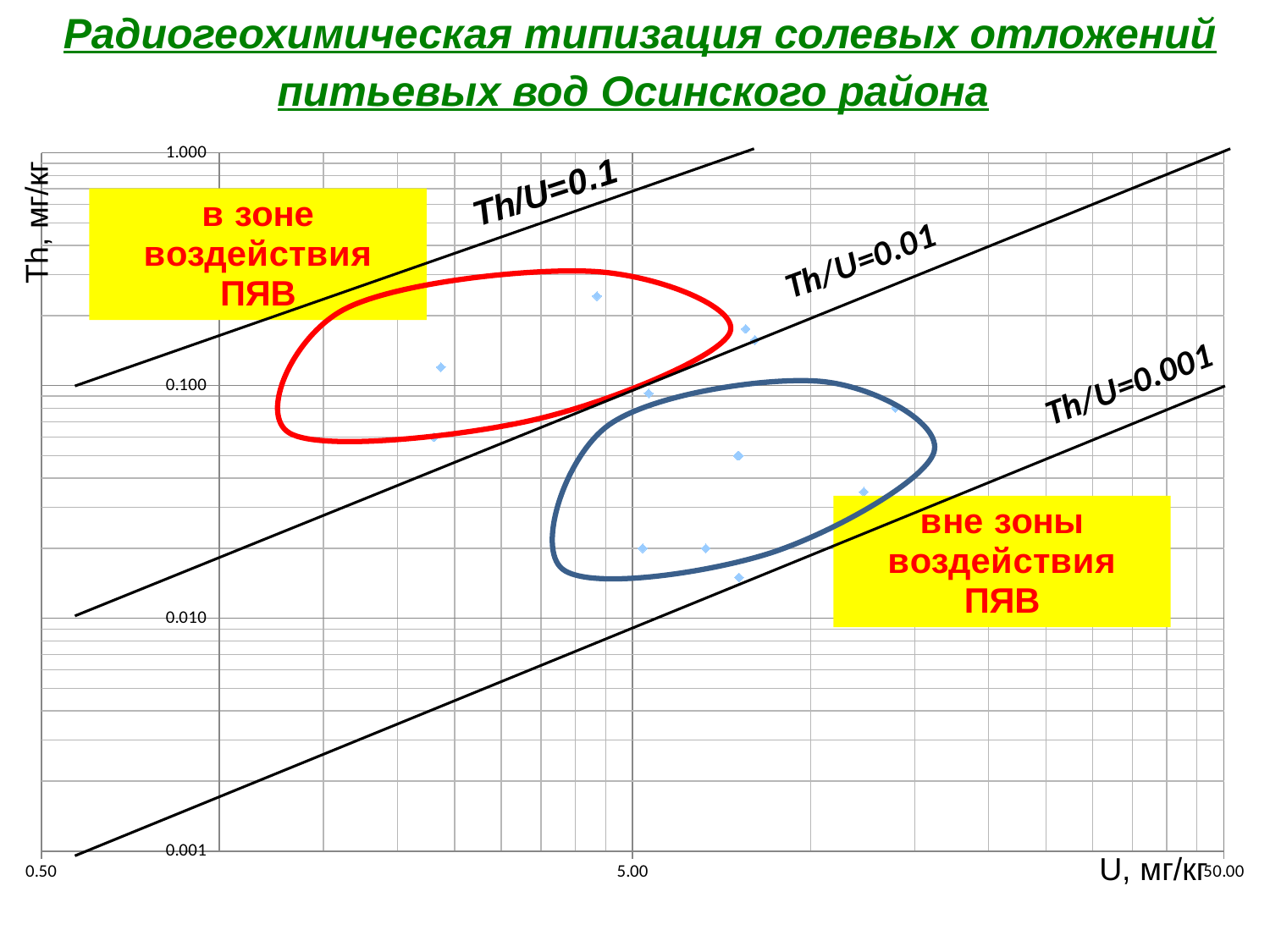
Are the points inside the blue ellipse above or below the Th/U=0.1 line? below Which group of points lies higher on the Th axis overall: the red ellipse group or the blue ellipse group? the red ellipse group How many Th/U ratio reference lines are drawn on the chart? 3 Is the highest point inside the red ellipse greater or less than 0.100 on the Th axis? greater What is the title of the chart on the slide? Радиогеохимическая типизация солевых отложений питьевых вод Осинского района Which Th/U ratio line is the topmost on the chart? Th/U=0.1 What label is written inside the yellow box next to the red ellipse? в зоне воздействия ПЯВ Which Th/U ratio line is the lowest on the chart? Th/U=0.001 What is the rightmost tick value shown on the U axis? 50.00 What kind of chart is shown on the slide? scatter chart What is the highest tick value shown on the Th axis? 1.000